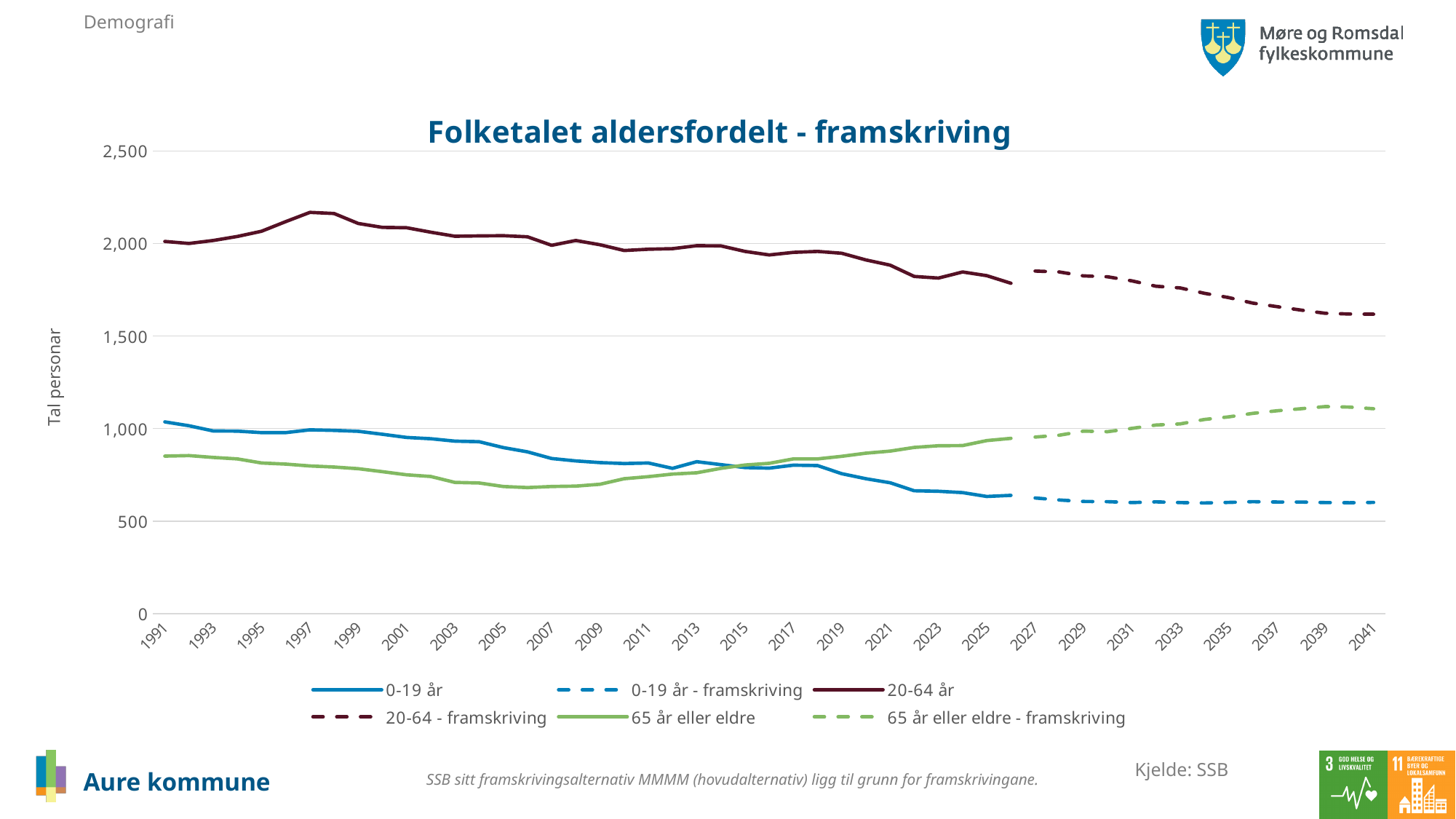
How many series does the legend list? 6 In 2041, which is larger: 65 år eller eldre - framskriving or 0-19 år - framskriving? 65 år eller eldre - framskriving Is the value for 65 år eller eldre in 2005 greater or less than 1,000? less What is the title of the chart? Folketalet aldersfordelt - framskriving What is the label of the vertical axis? Tal personar Is the value for 20-64 år in 1997 greater or less than 2,000? greater Is the value for 0-19 år in 1991 greater or less than 1,000? greater Which series has the highest value in 1991? 20-64 år Does the 65 år eller eldre series rise or fall between 2005 and 2025? Rise What kind of chart is shown on the slide? Line chart